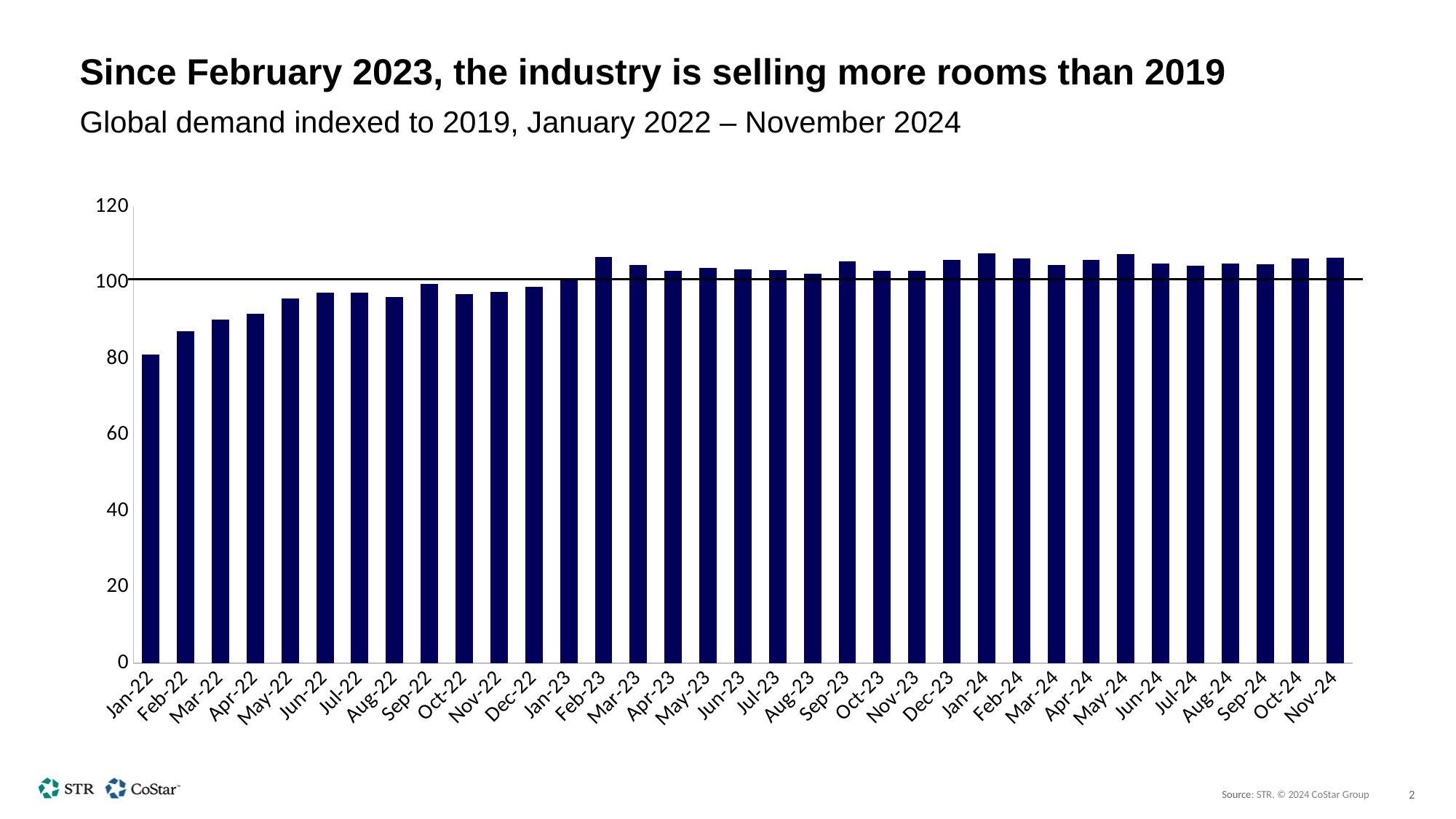
Is the value for Nov-24 greater or less than 100? greater How many monthly bars are plotted in the chart? 35 Which is larger, the value for Jan-22 or the value for Nov-24? Nov-24 Is the value for Feb-23 greater or less than 100? greater What is the title of the slide containing the chart? Since February 2023, the industry is selling more rooms than 2019 Is the value for Jan-22 greater or less than 60? greater What kind of chart is shown on the slide? bar chart Which month has the lowest value in the chart? Jan-22 Do the values rise or fall from Jan-22 to Feb-23? rise Which is larger, the value for Feb-22 or the value for Jun-22? Jun-22